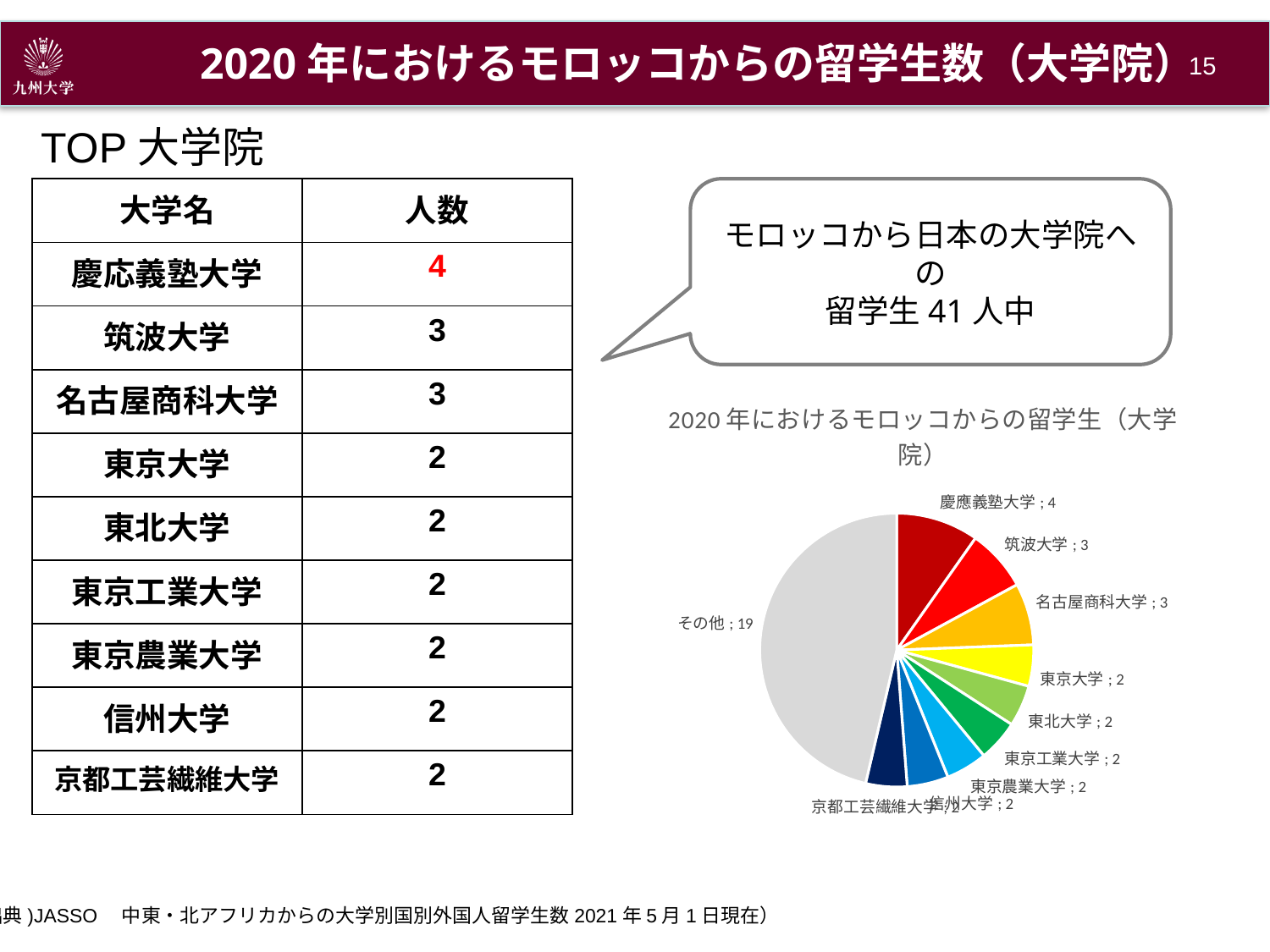
What is the difference between the values for その他 and 慶應義塾大学 in the pie chart? 15 In the pie chart, what is the value for 名古屋商科大学? 3 In the pie chart, which is larger, the value for 筑波大学 or the value for 東京大学? 筑波大学 In the pie chart, what is the value for 東京工業大学? 2 How many slices does the pie chart have? 10 In the pie chart, what is the value for 慶應義塾大学? 4 What kind of chart is shown on the slide? pie chart What is the difference between the values for 慶應義塾大学 and 筑波大学 in the pie chart? 1 What is the title of the pie chart? 2020年におけるモロッコからの留学生（大学院） Which slice of the pie chart is the largest? その他 Among the named universities in the pie chart, which has the highest value? 慶應義塾大学 In the pie chart, what is the value for その他? 19